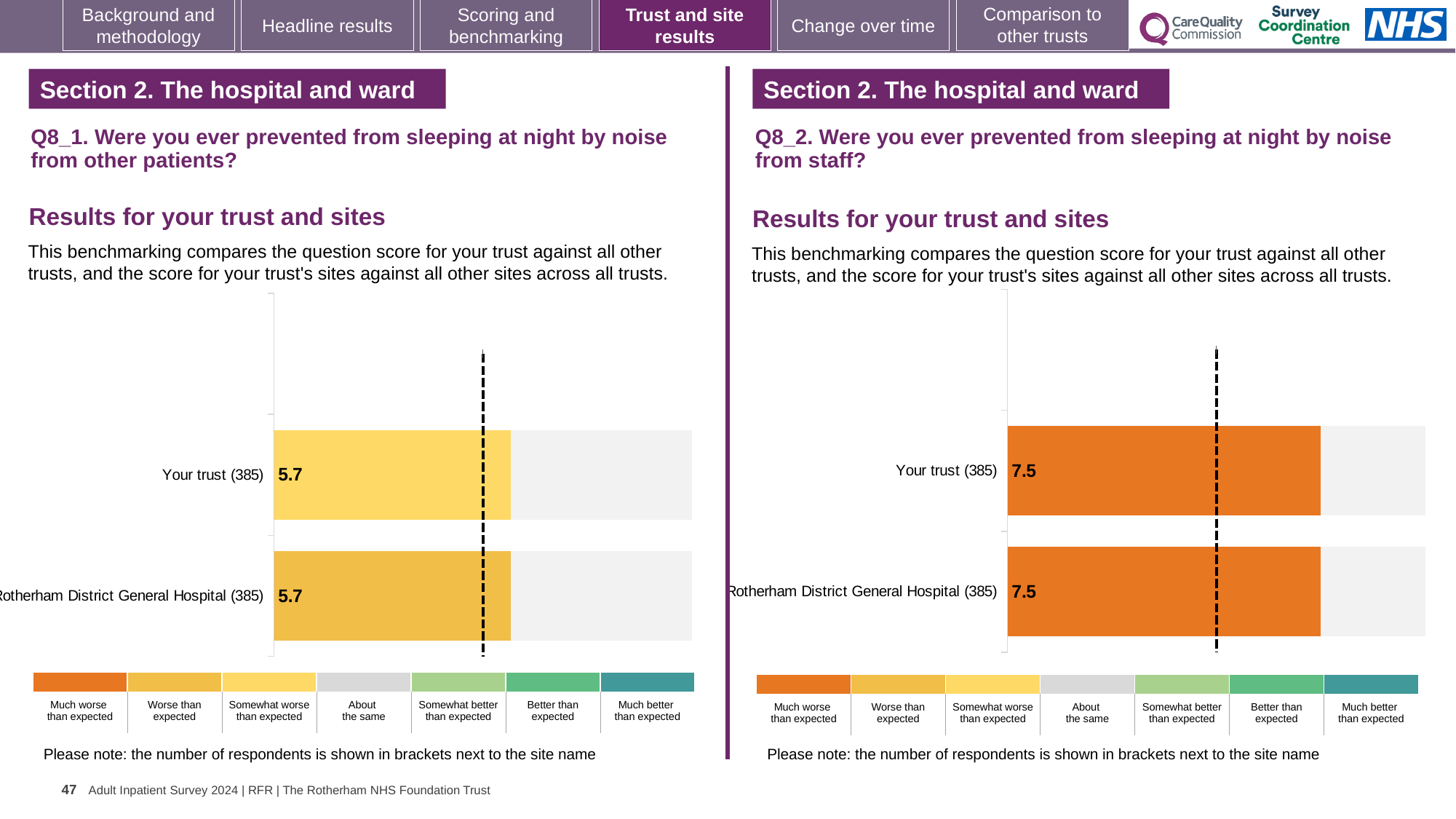
In the Q8_1 chart on the left, what is the difference between the score for Your trust and the score for Rotherham District General Hospital? 0.0 In the Q8_1 chart on the left, how many respondents are shown in brackets next to Your trust? 385 In the Q8_2 chart on the right, what is the score for Your trust? 7.5 How many bars are plotted in the Q8_2 chart on the right? 2 In the Q8_1 chart on the left, what is the score for Rotherham District General Hospital? 5.7 In the Q8_2 chart on the right, what is the difference between the score for Your trust and the score for Rotherham District General Hospital? 0.0 In the Q8_1 chart on the left, what is the score for Your trust? 5.7 How many bars are plotted in the Q8_1 chart on the left? 2 In the Q8_2 chart on the right, what is the score for Rotherham District General Hospital? 7.5 What kind of chart is used for the Q8_2 results on the right? Bar chart In the Q8_2 chart on the right, which benchmark category does the colour of the Your trust bar correspond to according to the key? Much worse than expected